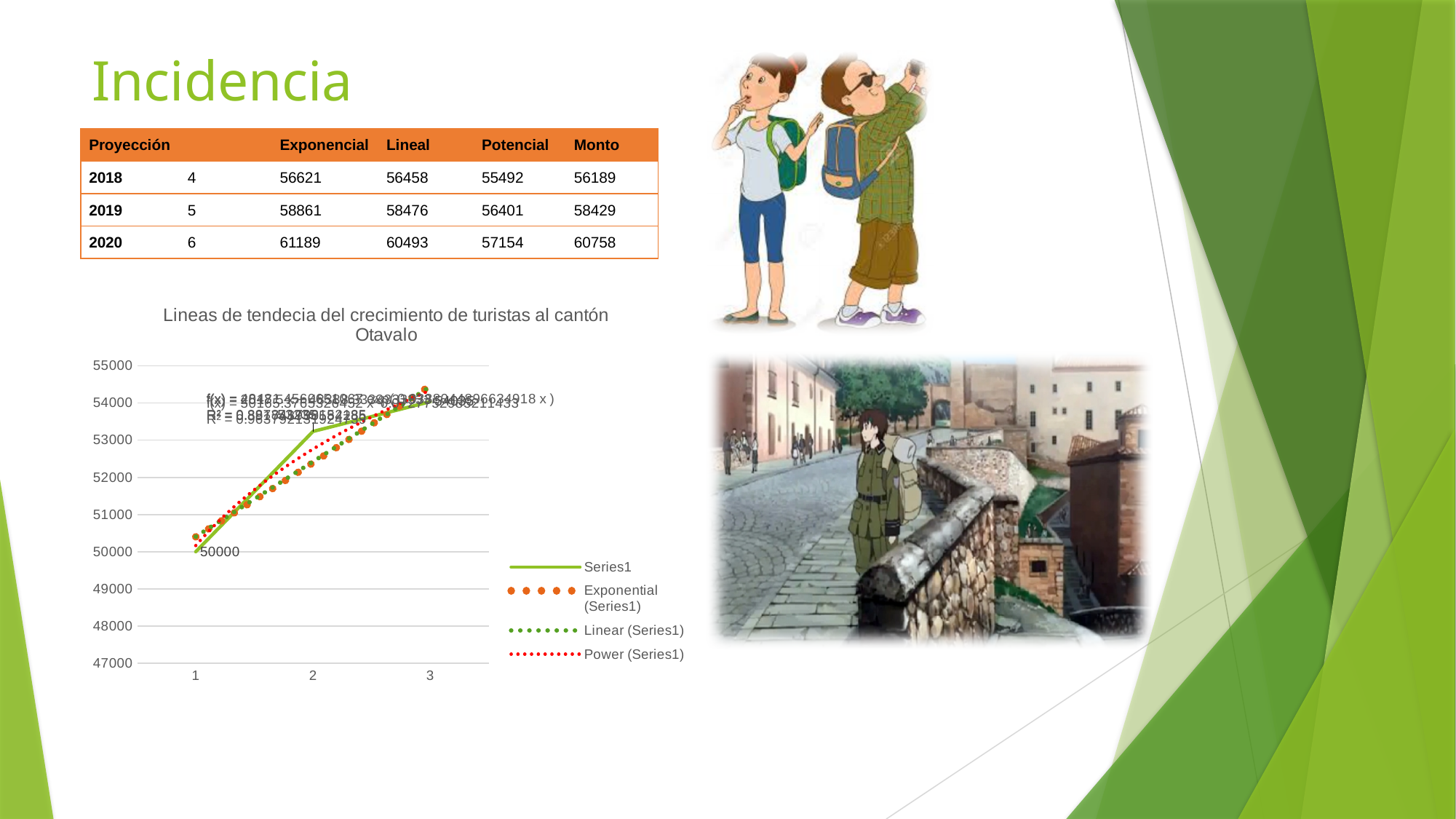
How many data points does Series1 have? 3 What is the title of the chart? Lineas de tendecia del crecimiento de turistas al cantón Otavalo How many entries does the chart legend list? 4 At which x value is Series1 lowest? 1 At which x value is Series1 highest? 3 Which is larger, the Series1 value at x = 1 or at x = 3? x = 3 Is the Series1 value at x = 2 greater or less than 54000? less Do the Series1 values rise or fall from x = 1 to x = 3? rise What is the value of Series1 at x = 1? 50000 Which legend entry is drawn as a red dotted line? Power (Series1) Is the Series1 value at x = 2 greater or less than 53000? greater What kind of chart is shown on the slide? line chart